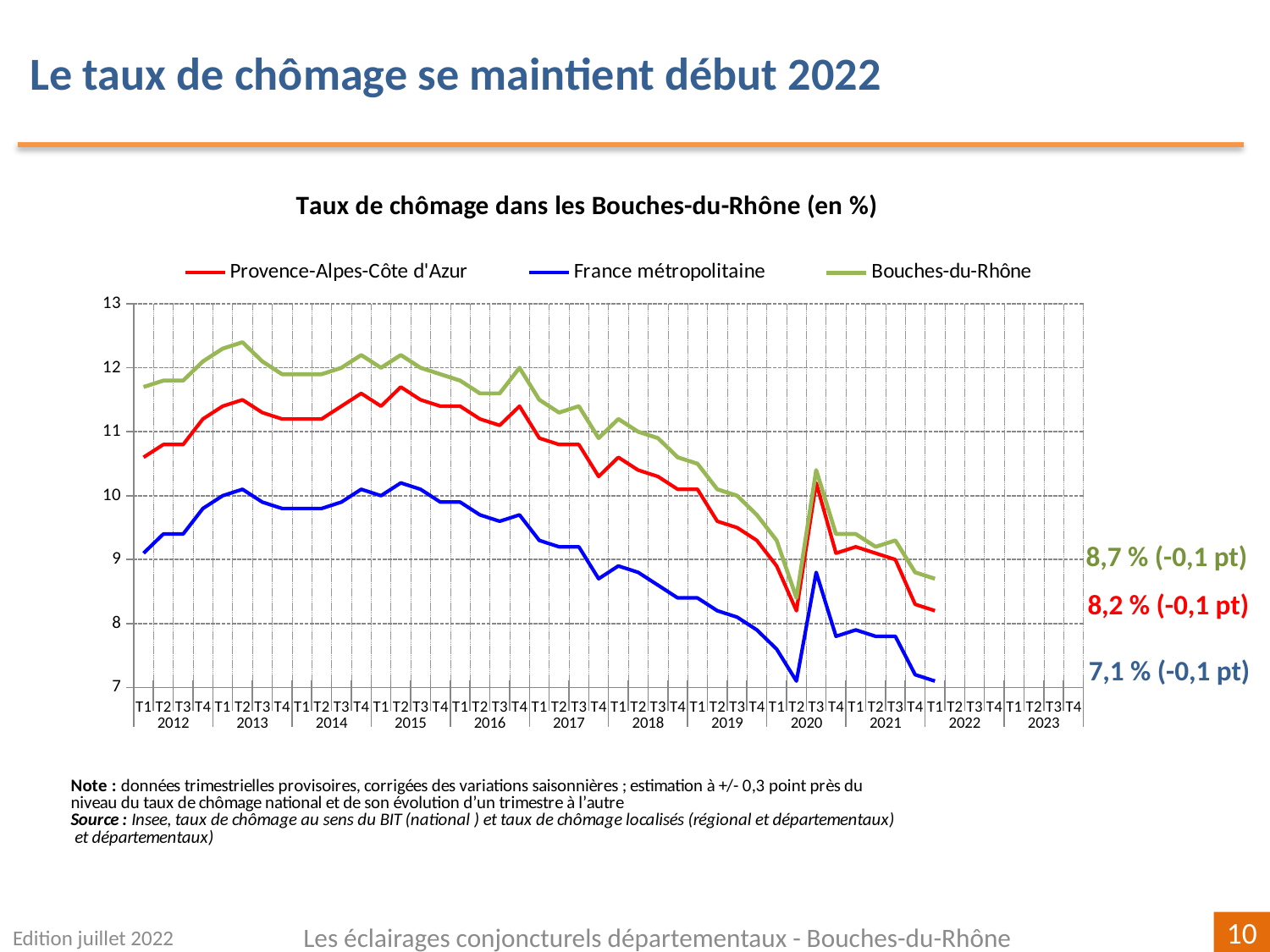
Which series has the highest value at the end of the chart? Bouches-du-Rhône Is the value for France métropolitaine in T1 2012 greater or less than 10? less What is the title of the chart? Taux de chômage dans les Bouches-du-Rhône (en %) How many series does the legend list? 3 What kind of chart is shown on the slide? Line chart What is the latest unemployment rate shown for Provence-Alpes-Côte d'Azur? 8,2 % At the latest point, is the rate for Provence-Alpes-Côte d'Azur higher or lower than that for France métropolitaine? Higher Which series has the lowest value at the end of the chart? France métropolitaine Is the value for Bouches-du-Rhône in T2 2013 greater or less than 12? greater What is the latest unemployment rate shown for Bouches-du-Rhône? 8,7 % What is the latest unemployment rate shown for France métropolitaine? 7,1 % What is the difference between the latest rates for Bouches-du-Rhône and France métropolitaine? 1,6 points